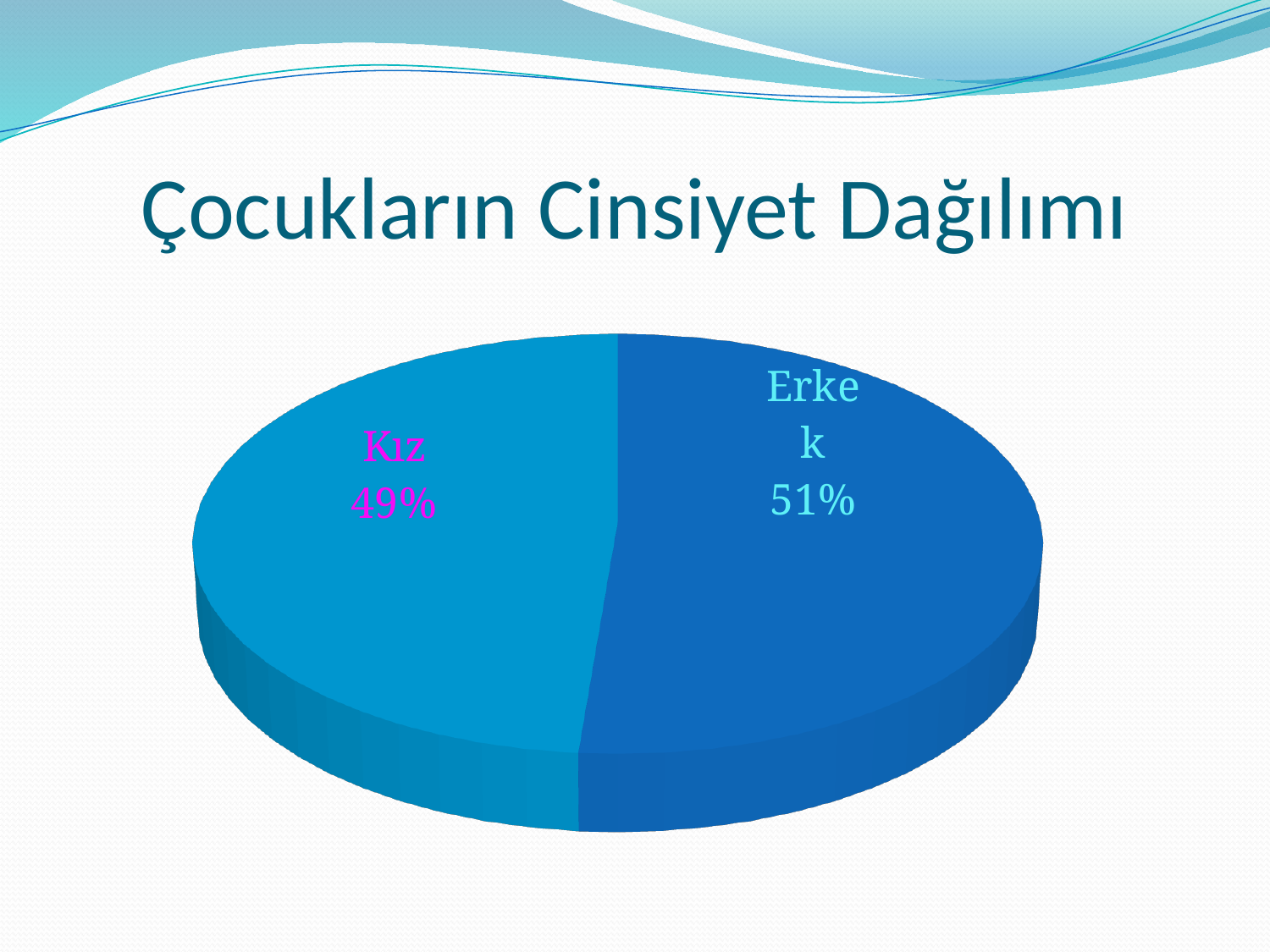
What is the title of the slide? Çocukların Cinsiyet Dağılımı What share of the pie does Erkek represent? 51% How many slices does the pie chart have? 2 Is the share for Kız greater or less than 50%? less Which category has the smallest slice of the pie? Kız What share of the pie does Kız represent? 49% Which category has the largest slice of the pie? Erkek What is the difference in percentage points between the Erkek and Kız slices? 2% What kind of chart is shown on the slide? Pie chart Is the share for Erkek greater or less than 50%? greater Which slice is larger, Kız or Erkek? Erkek What is the total of the two slice percentages shown? 100%